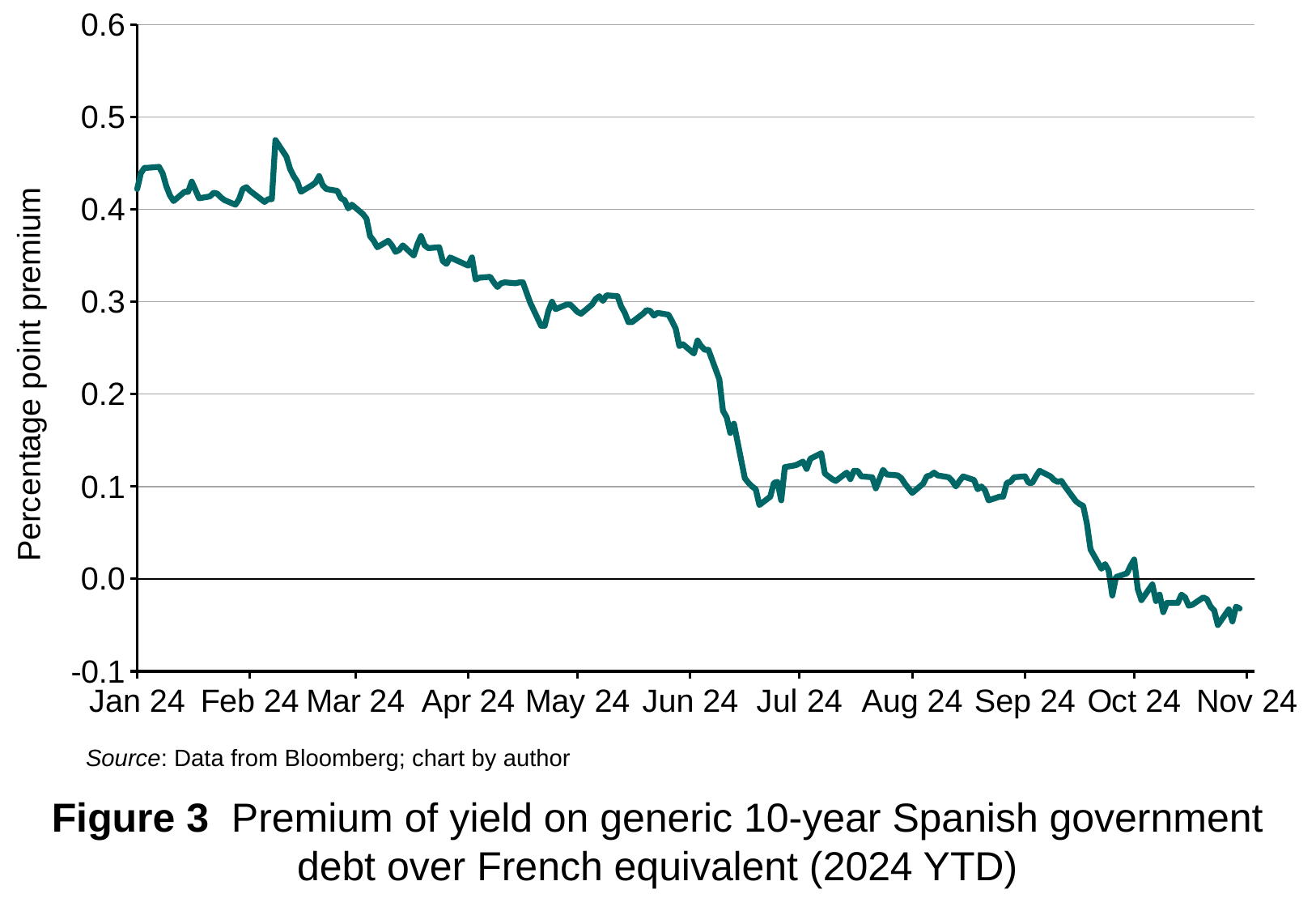
Is the value at Oct 24 greater or less than 0.1? less Is the value at Aug 24 greater or less than 0.2? less Does the premium generally rise or fall from Jan 24 to Nov 24? fall Which is larger, the value at Jan 24 or the value at Nov 24? Jan 24 Is the value at Apr 24 greater or less than 0.3? greater What is the label on the y axis? Percentage point premium How many month labels are shown on the x axis? 11 What is the source of the data given below the chart? Data from Bloomberg; chart by author What kind of chart is shown on the slide? line chart Which is larger, the value at Jun 24 or the value at Jul 24? Jun 24